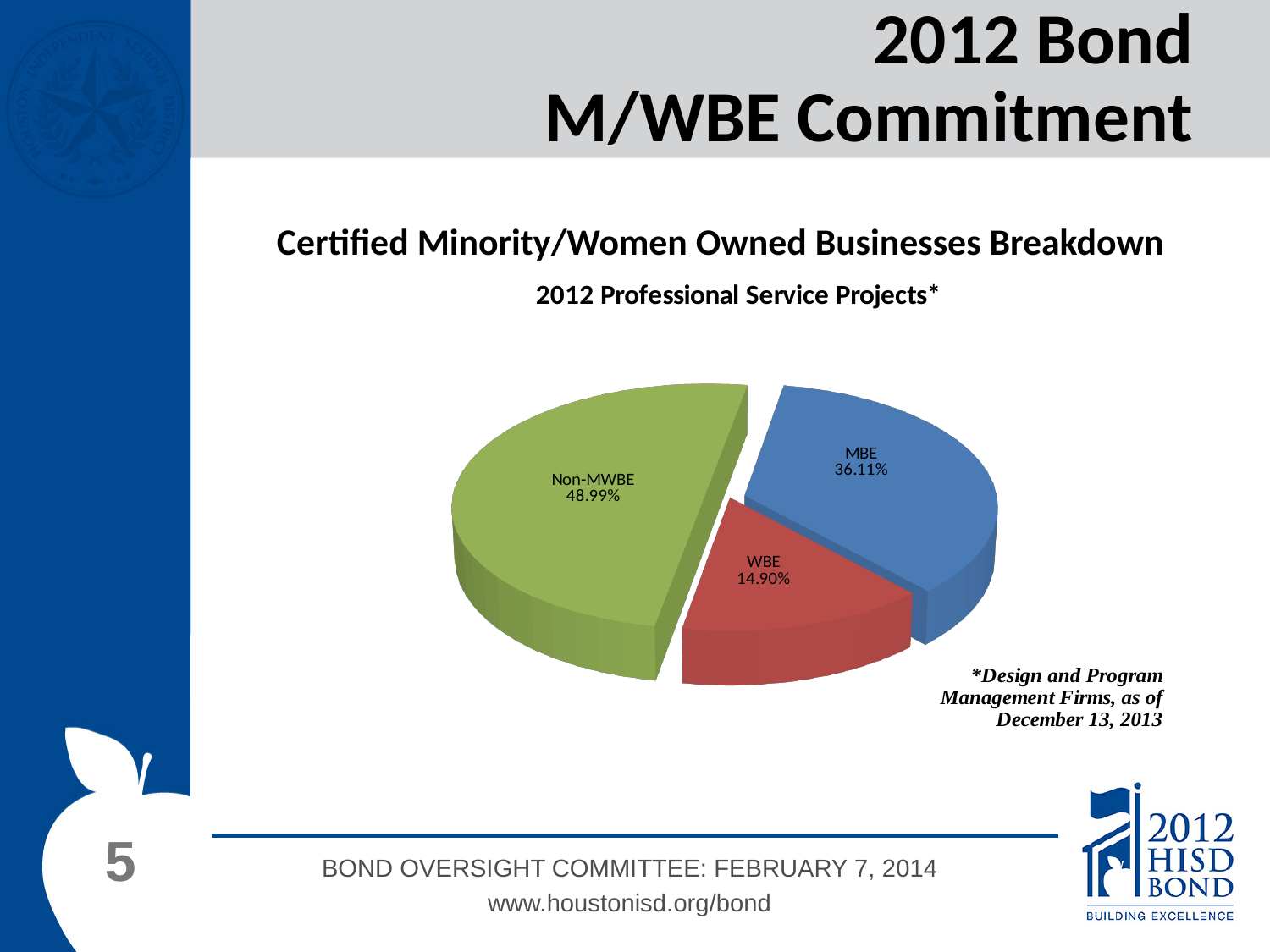
What colour is the Non-MWBE slice? Green What share of the pie does MBE represent? 36.11% Which is larger, the MBE slice or the WBE slice? MBE What share of the pie does Non-MWBE represent? 48.99% Which slice of the pie is the largest? Non-MWBE What is the difference in percentage points between the Non-MWBE slice and the MBE slice? 12.88 How many slices does the pie chart have? 3 What is the combined share of the MBE and WBE slices? 51.01% What is the title of the chart? 2012 Professional Service Projects* What kind of chart is shown on the slide? Pie chart Which slice of the pie is the smallest? WBE What share of the pie does WBE represent? 14.90%